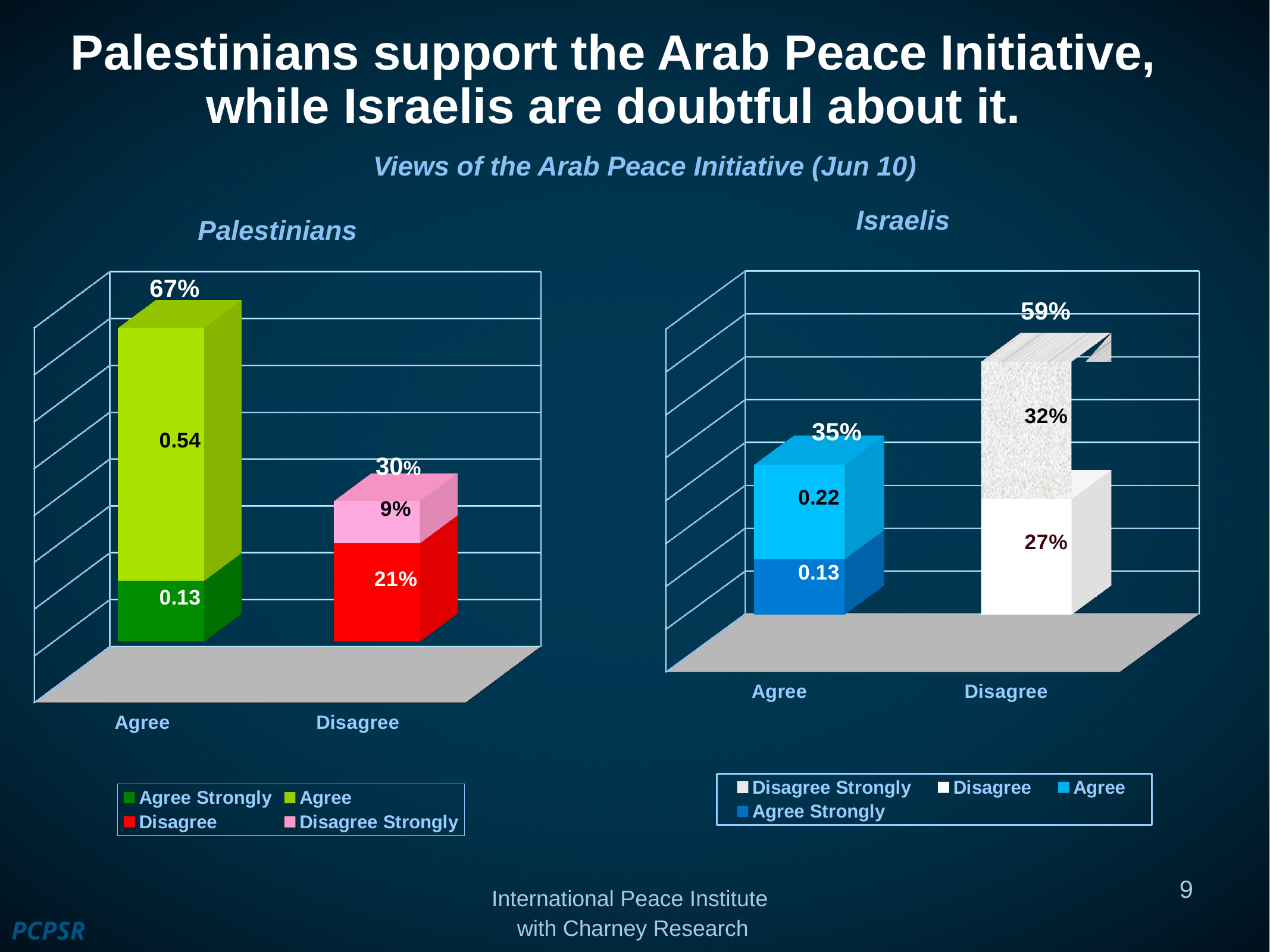
In the Israelis chart, what is the value of the Disagree segment in the Disagree bar? 27% How many series does the legend of the Israelis chart list? 4 What kind of chart is the Palestinians chart? Stacked bar chart In the Palestinians chart, what is the difference between the Agree bar total and the Disagree bar total? 37% In the Palestinians chart, what is the total shown above the Agree bar? 67% In the Palestinians chart, what is the value of the Agree segment in the Agree bar? 0.54 In the Israelis chart, what is the value of the Disagree Strongly segment? 32% In the Israelis chart, what is the total shown above the Agree bar? 35% In the Palestinians chart, what is the value of the Agree Strongly segment? 0.13 In the Palestinians chart, what is the total shown above the Disagree bar? 30% In the Israelis chart, which bar is taller, Agree or Disagree? Disagree In the Palestinians chart, what is the value of the Disagree Strongly segment? 9%